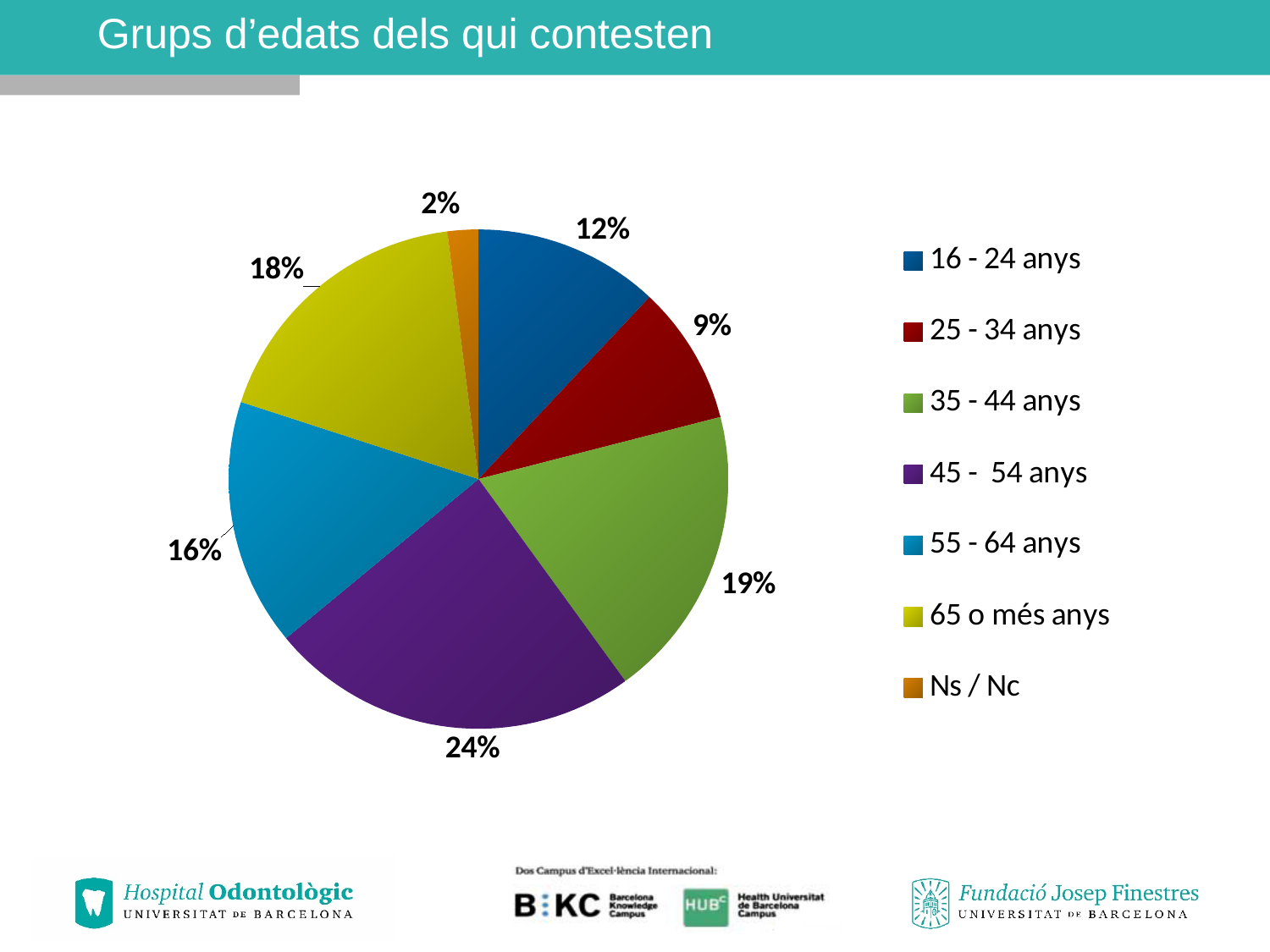
Which is larger, the share for 55 - 64 anys or the share for 65 o més anys? 65 o més anys What percentage is shown for Ns / Nc? 2% What kind of chart is shown on the slide? Pie chart What colour is the slice for 25 - 34 anys? Dark red What share of respondents are in the 45 - 54 anys group? 24% What share of respondents are in the 65 o més anys group? 18% How many categories does the legend list? 7 What share of respondents are in the 16 - 24 anys group? 12% What is the title of the chart? Grups d'edats dels qui contesten Which category has the smallest slice of the pie? Ns / Nc Which age group has the largest slice of the pie? 45 - 54 anys What is the difference in percentage points between the 35 - 44 anys group and the 25 - 34 anys group? 10